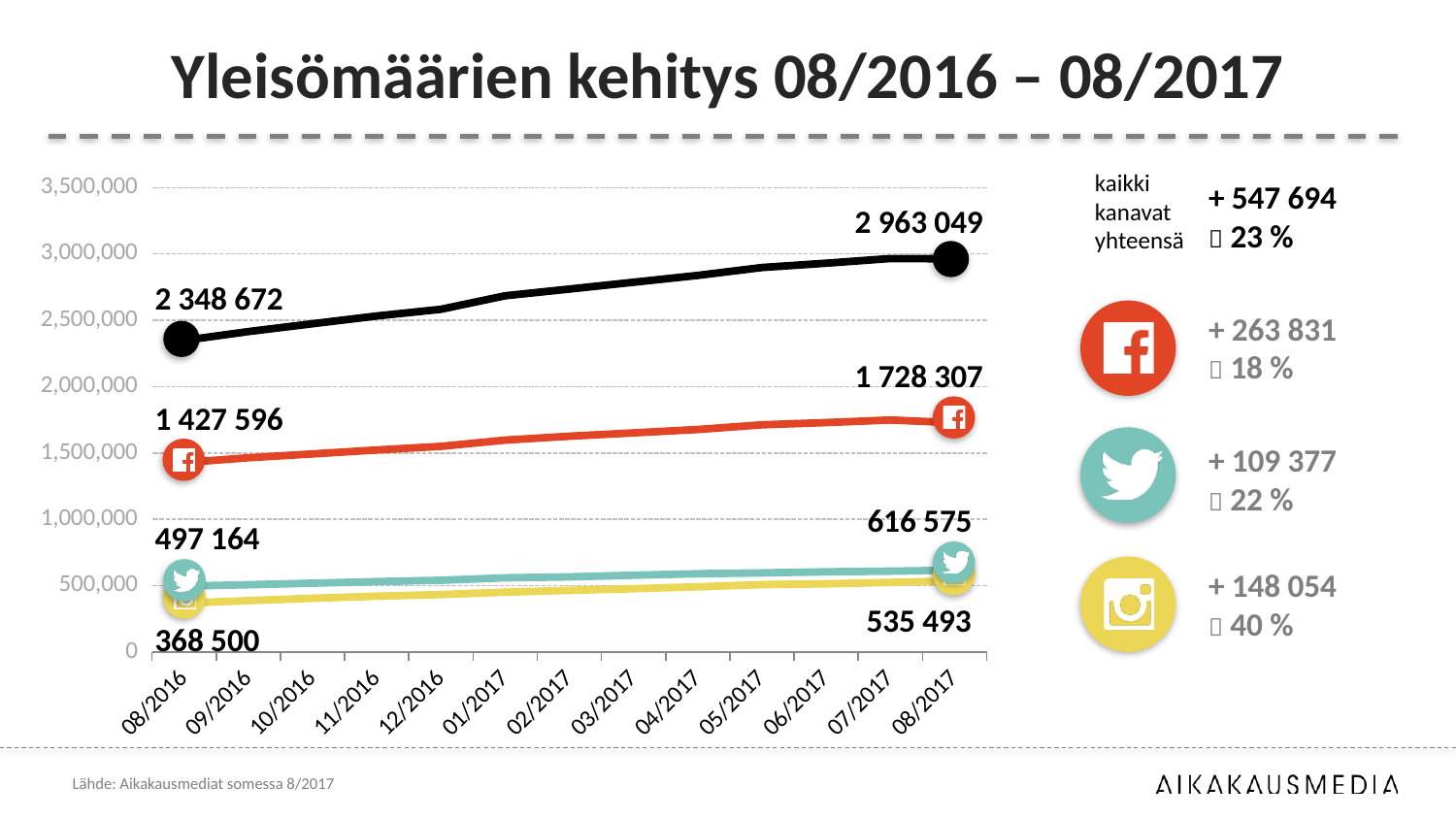
What is the Facebook value at 08/2017? 1 728 307 What is the Facebook value at 08/2016? 1 427 596 What is the Instagram value at 08/2016? 368 500 What is the value of the black (total) line at 08/2016? 2 348 672 Which is larger at 08/2017, the Twitter value or the Instagram value? Twitter What is the Twitter value at 08/2017? 616 575 Do the lines rise or fall from 08/2016 to 08/2017? rise How many lines are plotted on the chart? 4 What is the value of the black (total) line at 08/2017? 2 963 049 Is the value of the black (total) line at 02/2017 greater or less than 2,500,000? greater What type of chart is shown on the slide? line chart Which channel line has the lowest value at 08/2017? Instagram